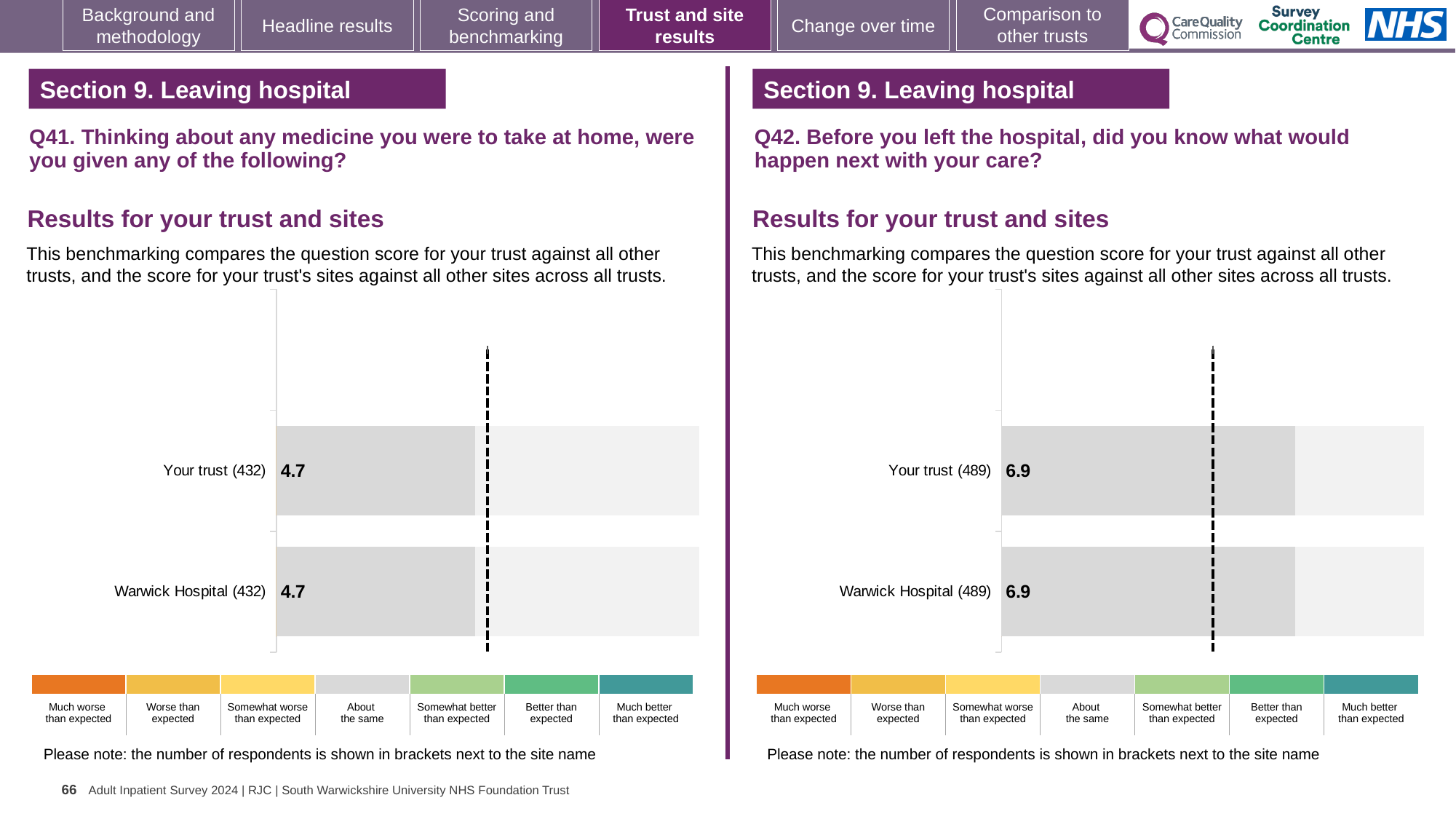
What kind of chart is used for the Q42 results on the right? Bar chart In the Q42 chart on the right, how many respondents are shown in brackets next to Your trust? 489 In the Q41 chart on the left, what is the score for Warwick Hospital? 4.7 In the Q41 chart on the left, what is the score for Your trust? 4.7 In the Q41 chart on the left, how many respondents are shown in brackets next to Warwick Hospital? 432 In the Q42 chart on the right, what is the difference between the score for Your trust and the score for Warwick Hospital? 0 In the Q41 chart on the left, what is the difference between the score for Your trust and the score for Warwick Hospital? 0 In the Q42 chart on the right, what is the score for Your trust? 6.9 How many bars are plotted in the Q42 chart on the right? 2 In the Q42 chart on the right, what is the score for Warwick Hospital? 6.9 How many benchmark categories are listed in the colour key below the Q41 chart on the left? 7 How many bars are plotted in the Q41 chart on the left? 2